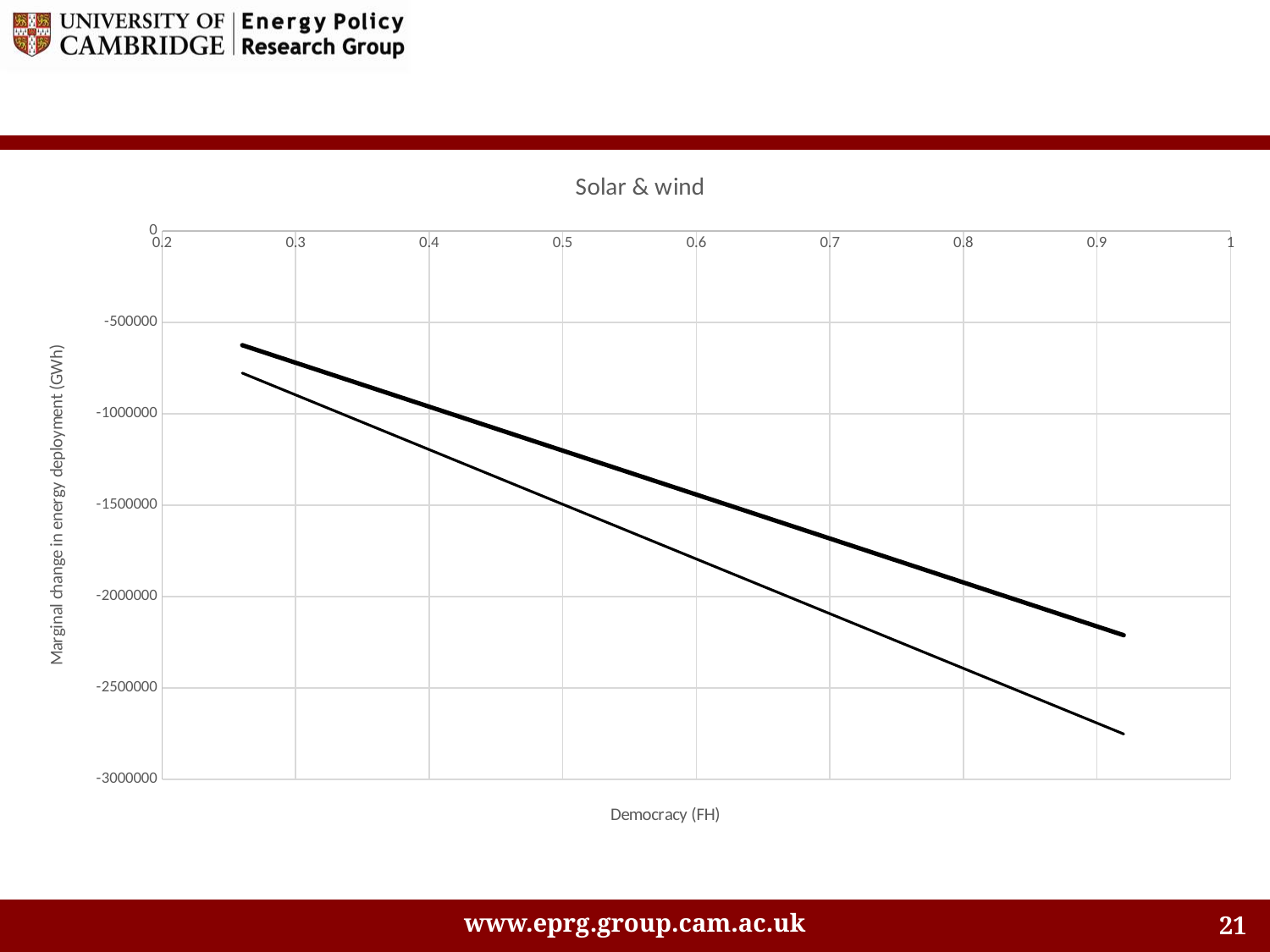
Is the value of the thin line at Democracy (FH) = 0.7 greater or less than -1500000? less Do the plotted values rise or fall as Democracy (FH) increases? Fall Is the value of the thick line at Democracy (FH) = 0.3 greater or less than -1000000? greater How many lines are plotted on the chart? 2 What is the title of the chart? Solar & wind Is the value of the thick line at Democracy (FH) = 0.5 greater or less than -1500000? greater At Democracy (FH) = 0.6, which line has the higher value, the thick line or the thin line? The thick line Which line reaches the lowest value on the chart, the thick line or the thin line? The thin line What kind of chart is shown on the slide? Line chart What is the label of the x axis? Democracy (FH)